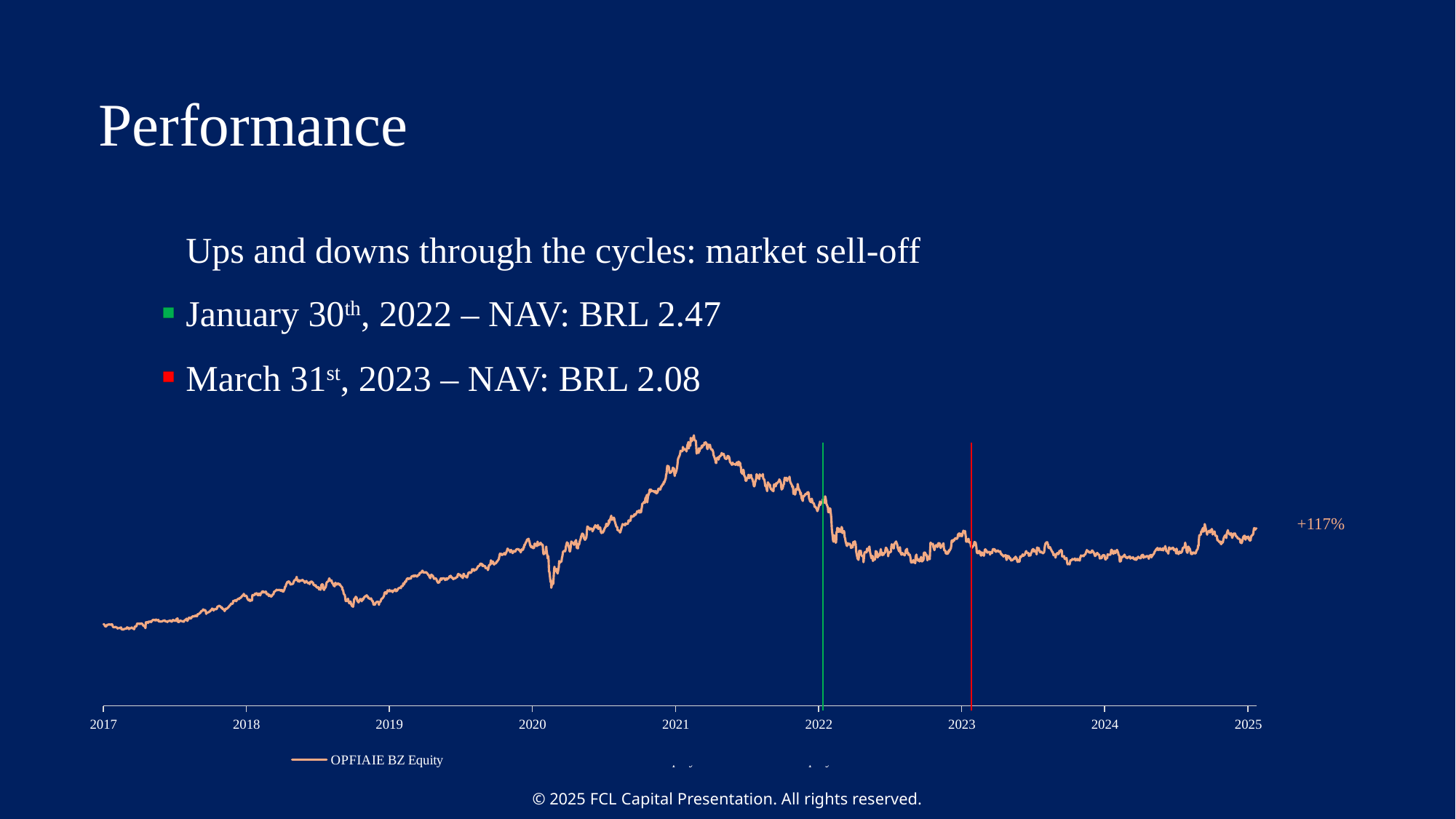
What series name does the chart legend show? OPFIAIE BZ Equity What percentage label is printed at the right end of the line? +117% What kind of chart is shown on the slide? line chart How many year labels are shown on the x axis? 9 What is the last year labelled on the x axis? 2025 What is the first year labelled on the x axis? 2017 What NAV is given for January 30th, 2022? BRL 2.47 Does the line rise or fall between the green vertical line and the red vertical line? fall What is the difference between the NAV on January 30th, 2022 and the NAV on March 31st, 2023? BRL 0.39 Is the line higher at 2021 or at 2023? 2021 Overall, does the line rise or fall from 2017 to 2025? rise In which labelled year does the line reach its highest point? 2021